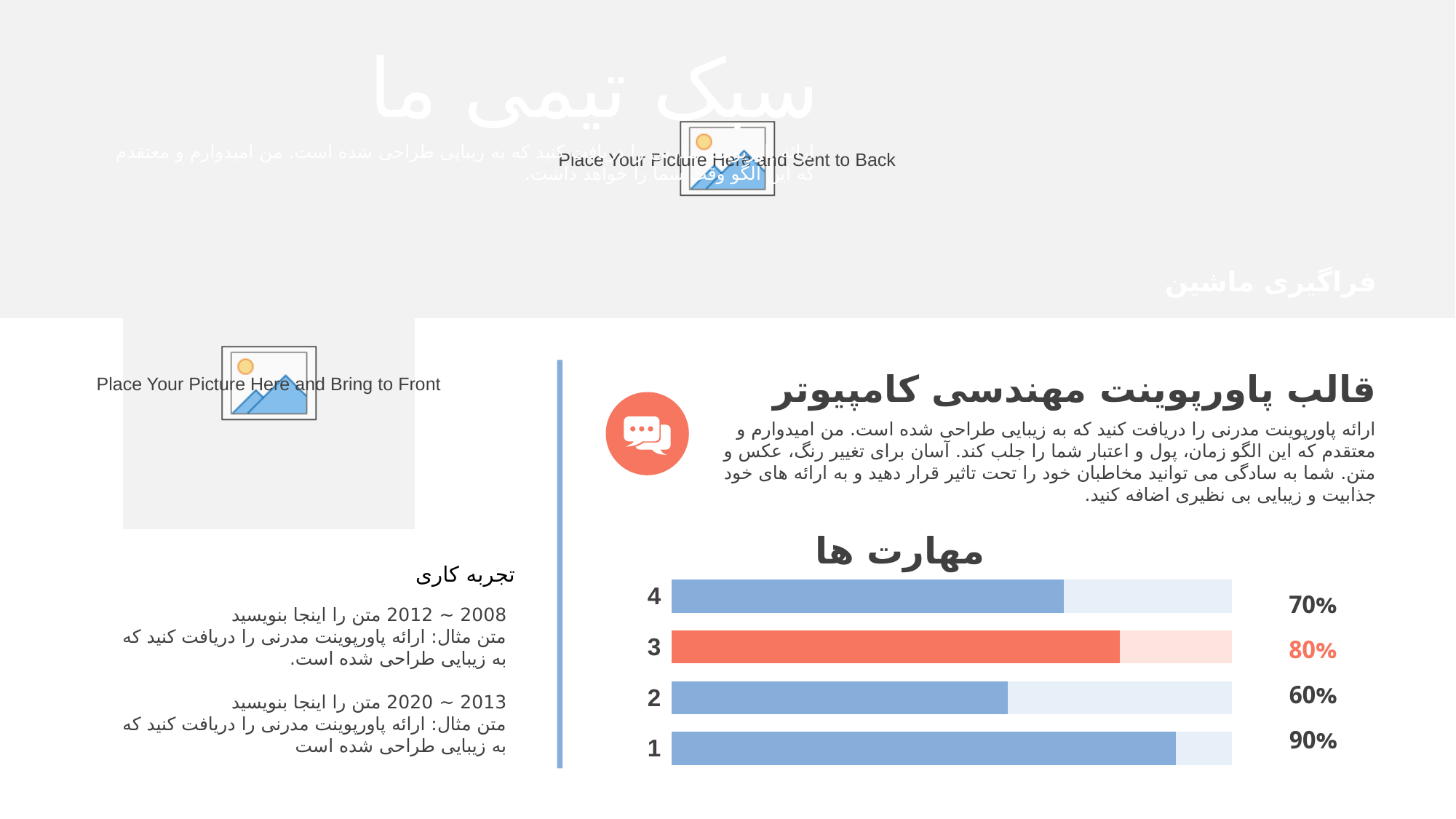
How many categories are shown in the "مهارت ها" chart? 4 What is the difference between the values for category 1 and category 2 in the "مهارت ها" chart? 30% What is the value for category 2 in the "مهارت ها" chart? 60% What is the value for category 4 in the "مهارت ها" chart? 70% What is the difference between the values for category 3 and category 4 in the "مهارت ها" chart? 10% Which is larger in the "مهارت ها" chart, the value for category 3 or category 4? category 3 Which category has the highest value in the "مهارت ها" chart? 1 What is the value for category 1 in the "مهارت ها" chart? 90% What kind of chart is the "مهارت ها" chart? bar chart Which category has the lowest value in the "مهارت ها" chart? 2 What is the value for category 3 in the "مهارت ها" chart? 80% Which category's bar is coloured orange in the "مهارت ها" chart? 3